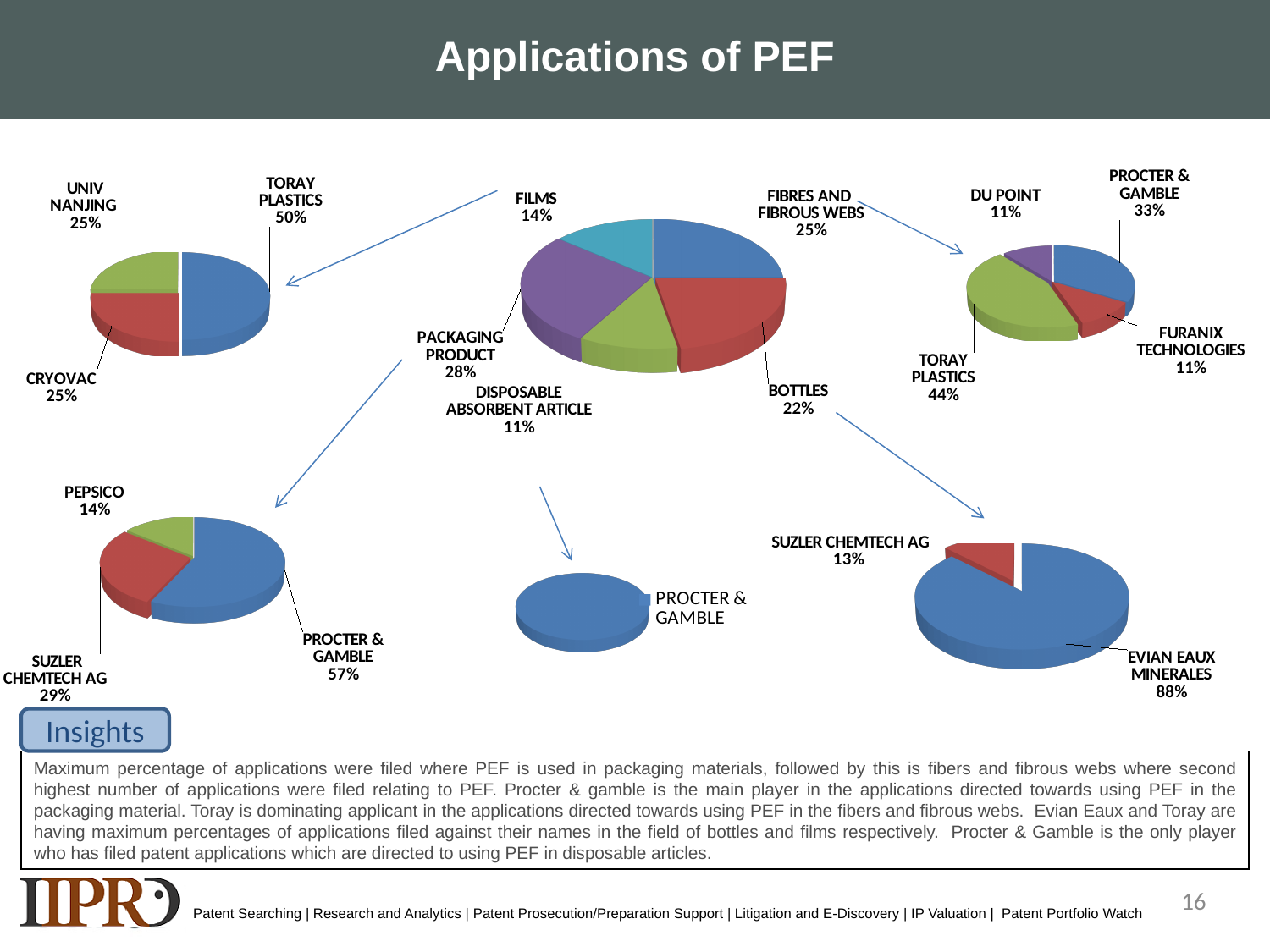
In the top-right pie chart, which applicant has the largest share? Toray Plastics In the central pie chart, which category has the smallest share? Disposable Absorbent Article In the central pie chart, what is the difference between the shares for Fibres and Fibrous Webs and Bottles? 3% In the bottom-left pie chart, which is larger, the share for Procter & Gamble or the share for Suzler Chemtech AG? Procter & Gamble How many categories does the central pie chart show? 5 In the bottom-right pie chart, what percentage is shown for Evian Eaux Minerales? 88% In the bottom-left pie chart, what is the difference between the shares for Procter & Gamble and Pepsico? 43% In the central pie chart, which category has the largest share? Packaging Product In the top-right pie chart, what percentage is shown for Procter & Gamble? 33% In the top-left pie chart, what percentage is shown for Toray Plastics? 50% In the central pie chart, what percentage is shown for Packaging Product? 28% What type of chart is used on this slide? Pie chart